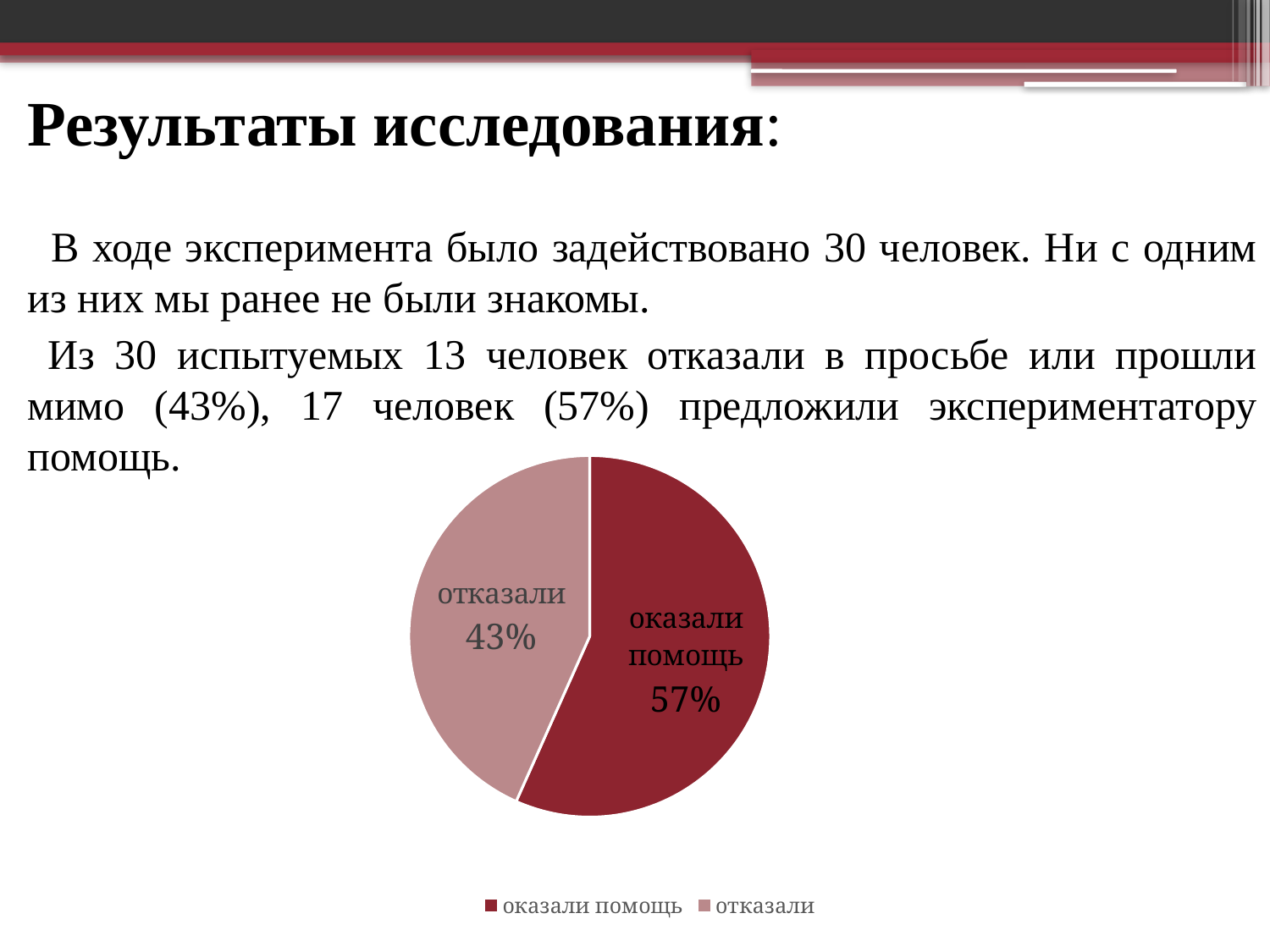
Is the value for "отказали" greater or less than 50%? less How many slices does the pie chart have? 2 Which is larger: the "оказали помощь" slice or the "отказали" slice? оказали помощь What kind of chart is shown on the slide? pie chart Which slice of the pie chart is the largest? оказали помощь Which slice of the pie chart is the smallest? отказали How many entries does the legend list? 2 What share of the pie does the "оказали помощь" slice represent? 57% Where is the legend positioned relative to the pie chart? below the chart What is the difference in percentage points between the "оказали помощь" and "отказали" slices? 14 What share of the pie does the "отказали" slice represent? 43% Which legend entry is shown in the darker red colour? оказали помощь